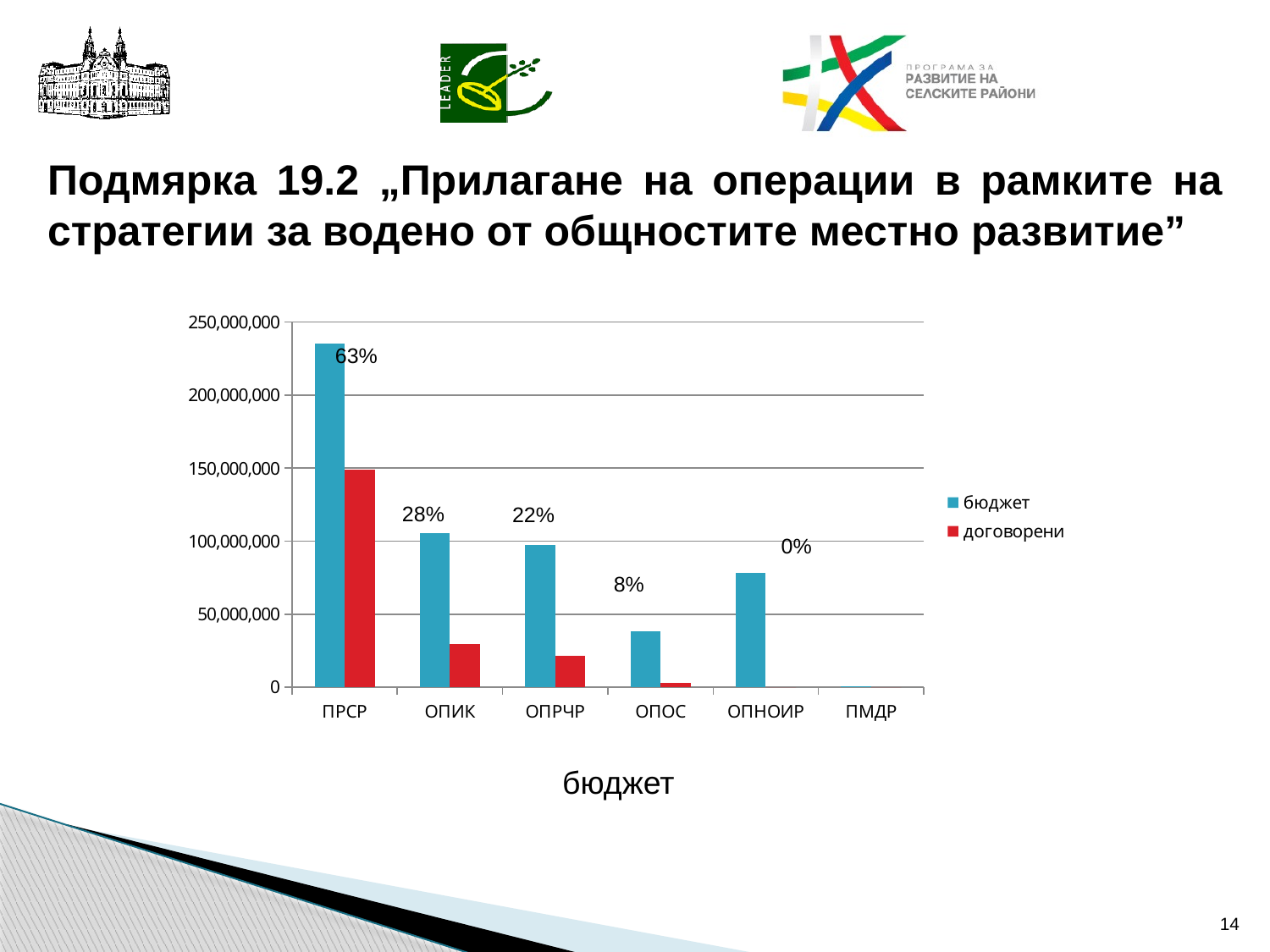
How many categories are shown on the x axis? 6 How many series does the legend list? 2 Is the бюджет value for ПРСР greater or less than 200,000,000? greater What percentage label is shown for ОПИК? 28% What percentage label is shown for ПРСР? 63% Which colour represents the договорени series in the legend? red What kind of chart is shown on the slide? bar chart Which is larger, the договорени value for ОПИК or the договорени value for ОПРЧР? ОПИК Is the бюджет value for ОПОС greater or less than 50,000,000? less What percentage label is shown for ОПОС? 8% What percentage label is shown for ОПНОИР? 0% Which category has the highest бюджет value? ПРСР